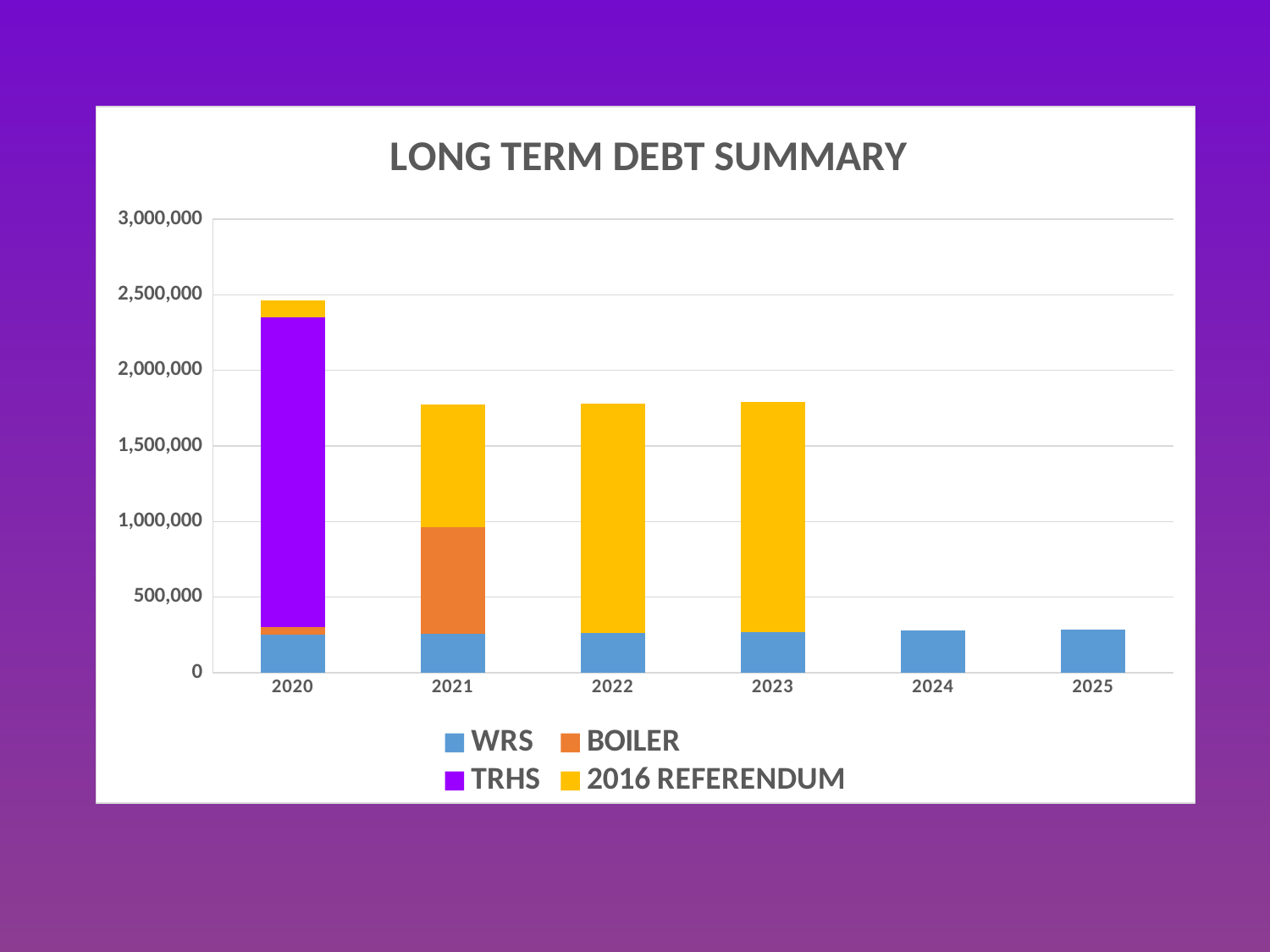
Which is larger, the total debt for 2023 or for 2024? 2023 How many series does the legend list? 4 Which is larger, the total debt for 2020 or for 2021? 2020 Which year has the highest total long term debt? 2020 Which series appears only in the 2020 bar? TRHS Is the total debt for 2021 greater or less than 1,500,000? greater What type of chart is shown on the slide? Stacked bar chart Is the total debt for 2024 greater or less than 500,000? less Does the total debt generally rise or fall from 2020 to 2025? fall How many years are shown on the x axis? 6 What is the title of the chart? LONG TERM DEBT SUMMARY Is the total debt for 2020 greater or less than 2,000,000? greater